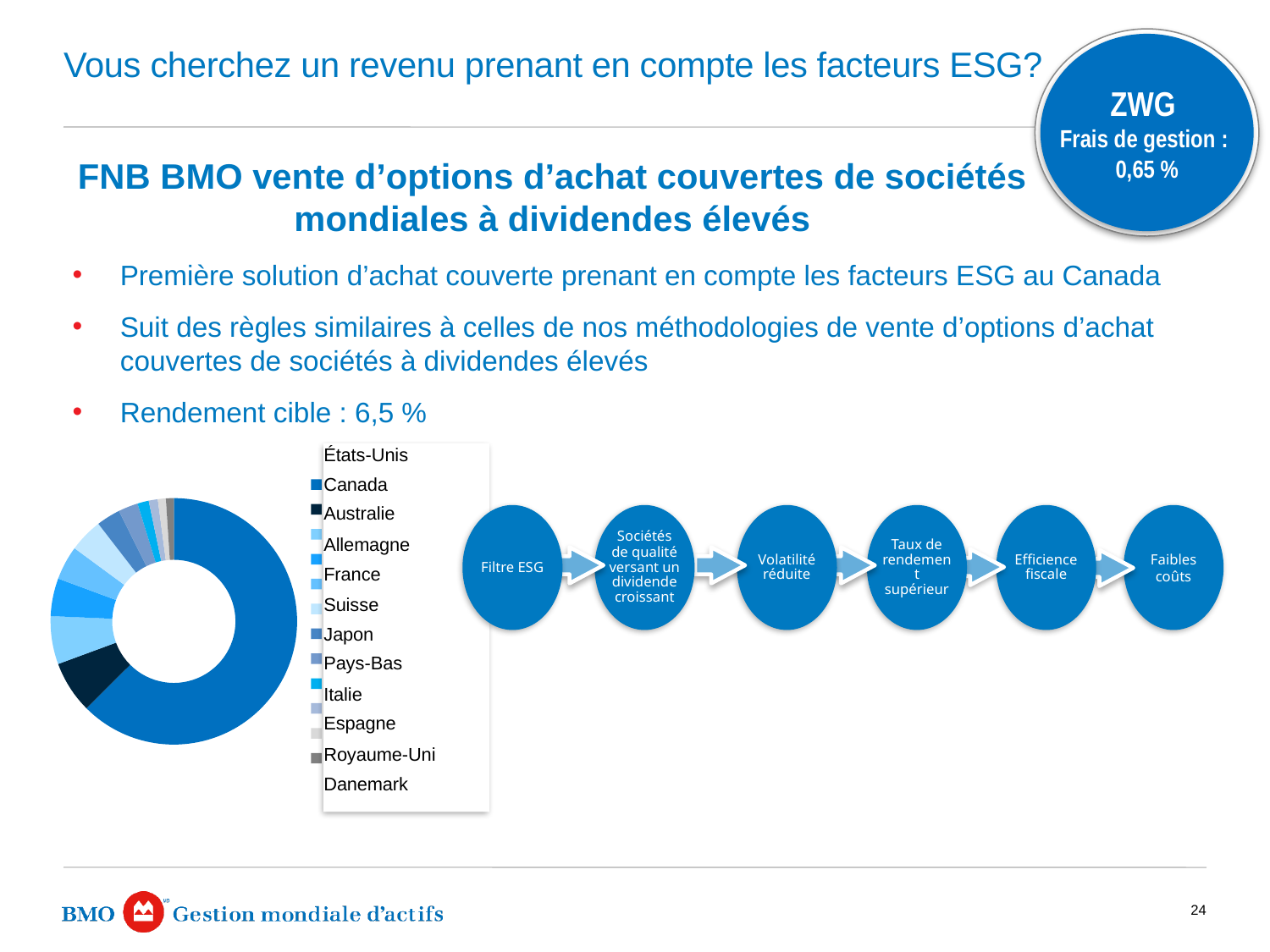
Which country has the largest slice in the pie chart? États-Unis Which slice is larger in the pie chart, États-Unis or Japon? États-Unis Which slice is larger in the pie chart, États-Unis or Australie? États-Unis Which slice is larger in the pie chart, États-Unis or Canada? États-Unis Which country is listed first in the legend of the pie chart? États-Unis What kind of chart is shown on the left of the slide? Pie chart (donut) Which country is listed last in the legend of the pie chart? Danemark How many countries are listed in the legend of the pie chart? 12